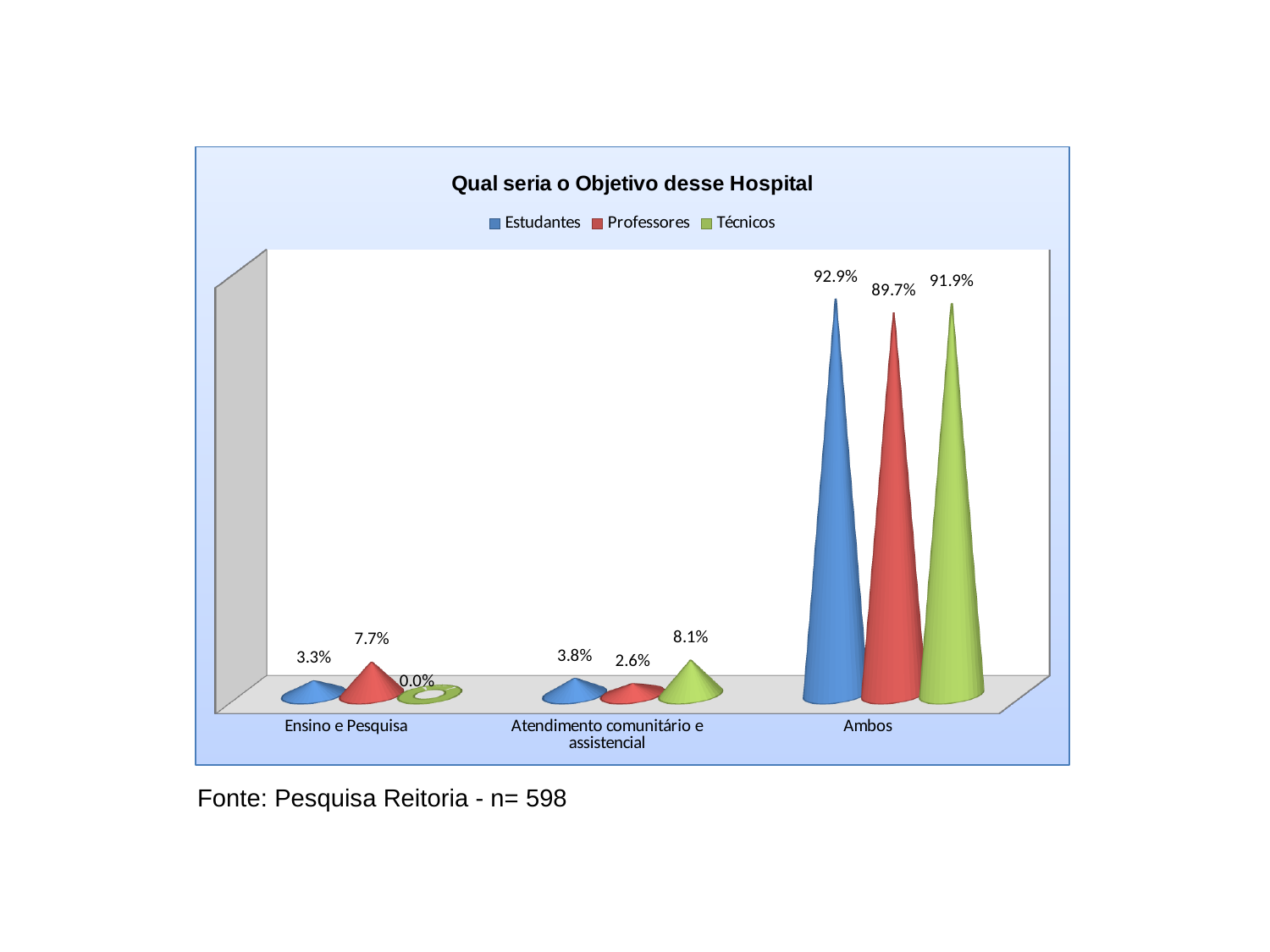
What is the value for Professores in the Ensino e Pesquisa category? 7.7% Which category has the lowest value for Técnicos? Ensino e Pesquisa In the Atendimento comunitário e assistencial category, which is larger: the Estudantes value or the Professores value? Estudantes What is the title of the chart? Qual seria o Objetivo desse Hospital What is the value for Estudantes in the Ambos category? 92.9% What kind of chart is shown on the slide? Bar chart Which category has the highest value for Professores? Ambos What is the value for Técnicos in the Atendimento comunitário e assistencial category? 8.1% How many series does the legend list? 3 How many categories are shown on the x axis? 3 What is the difference between the Estudantes and Professores values in the Ambos category? 3.2% What is the value for Técnicos in the Ensino e Pesquisa category? 0.0%